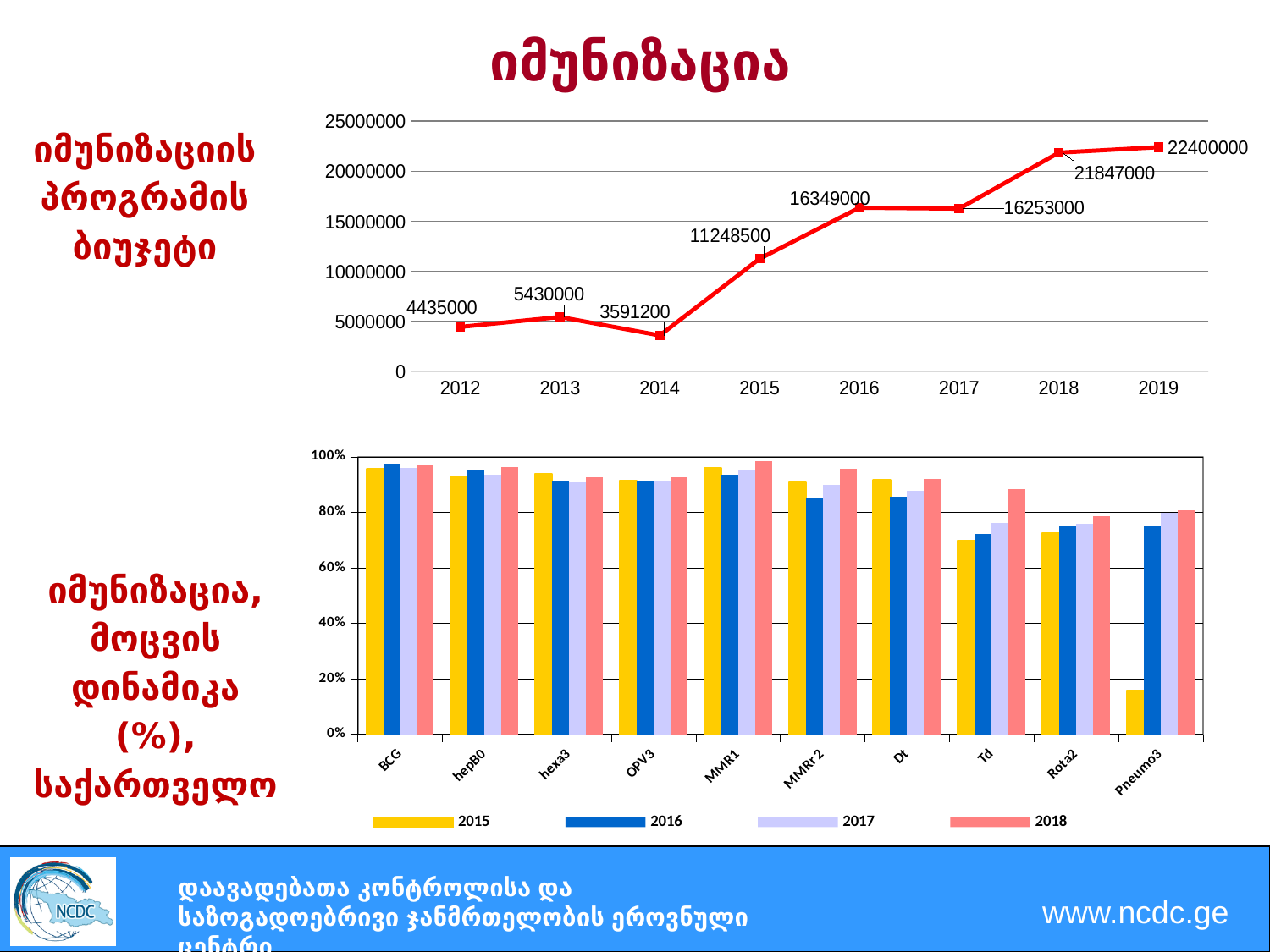
In the top line chart, which year has the lowest value? 2014 In the top line chart, which year has the larger value, 2016 or 2017? 2016 In the bottom bar chart, is the 2015 value for Td greater or less than 80%? less In the bottom bar chart, how many series does the legend list? 4 In the top line chart, what is the value for 2015? 11248500 In the top line chart, what is the difference between the values for 2019 and 2018? 553000 In the bottom bar chart, is the 2015 value for Pneumo3 greater or less than 20%? less What kind of chart is the top chart on the slide? line chart In the bottom bar chart, how many vaccine categories are shown on the x axis? 10 In the top line chart, which year has the highest value? 2019 In the top line chart, what is the value for 2018? 21847000 How many years are plotted on the top line chart? 8